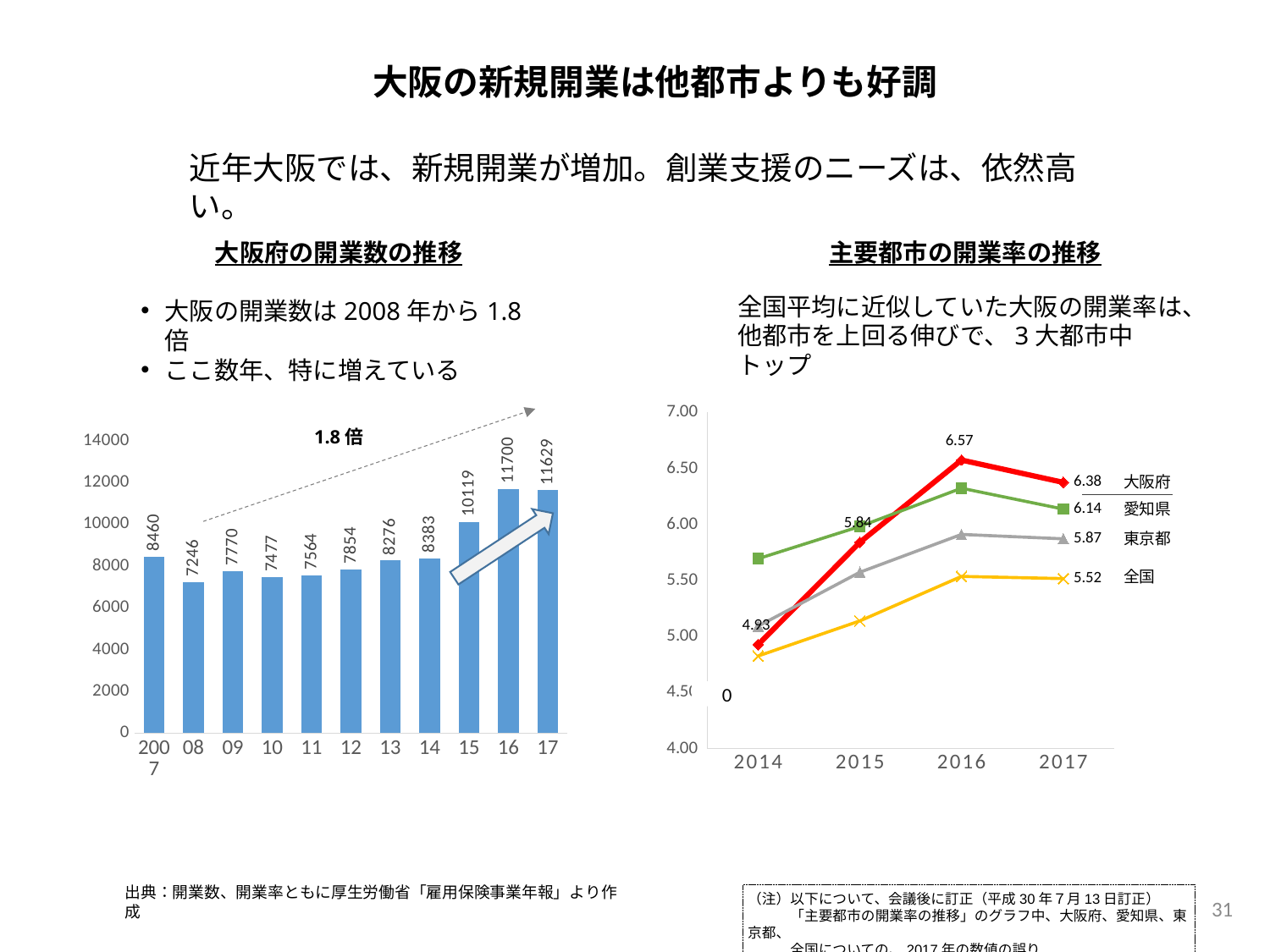
In the line chart 主要都市の開業率の推移, what is the value for 愛知県 in 2017? 6.14 How many bars are in the bar chart 大阪府の開業数の推移? 11 In the bar chart 大阪府の開業数の推移, which year has the highest value? 2016 In the line chart 主要都市の開業率の推移, is the value for 東京都 in 2014 greater or less than 6.00? less In the bar chart 大阪府の開業数の推移, which is larger, the value for 2014 or the value for 2015? 2015 In the bar chart 大阪府の開業数の推移, what is the difference between the 2017 value and the 2007 value? 3169 In the line chart 主要都市の開業率の推移, what is the value for 大阪府 in 2016? 6.57 How many series are shown in the line chart 主要都市の開業率の推移? 4 In the bar chart 大阪府の開業数の推移, which year has the lowest value? 2008 In the bar chart 大阪府の開業数の推移, what is the value for 2016? 11700 What kind of chart is 大阪府の開業数の推移? bar chart In the line chart 主要都市の開業率の推移, what is the difference between the 2017 values for 大阪府 and 全国? 0.86